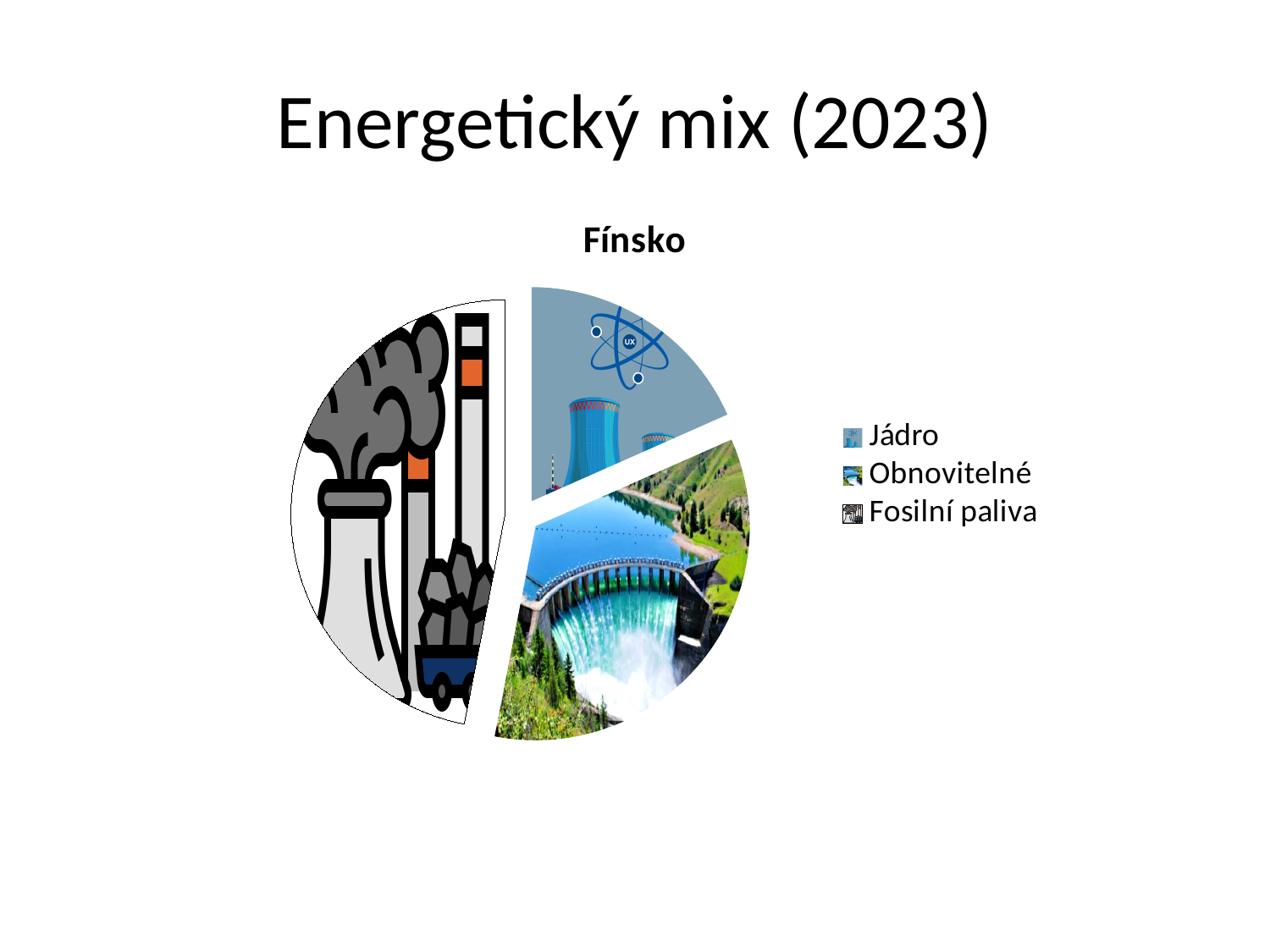
Which slice is larger, Fosilní paliva or Obnovitelné? Fosilní paliva Which legend entry is listed first in the pie chart's legend? Jádro Which slice is larger, Jádro or Obnovitelné? Obnovitelné Which slice is larger, Jádro or Fosilní paliva? Fosilní paliva Which category has the smallest slice of the pie chart? Jádro How many slices does the pie chart have? 3 What kind of chart is shown on the slide? pie chart What is the title of the pie chart? Fínsko How many entries does the legend list? 3 Which category has the largest slice of the pie chart? Fosilní paliva